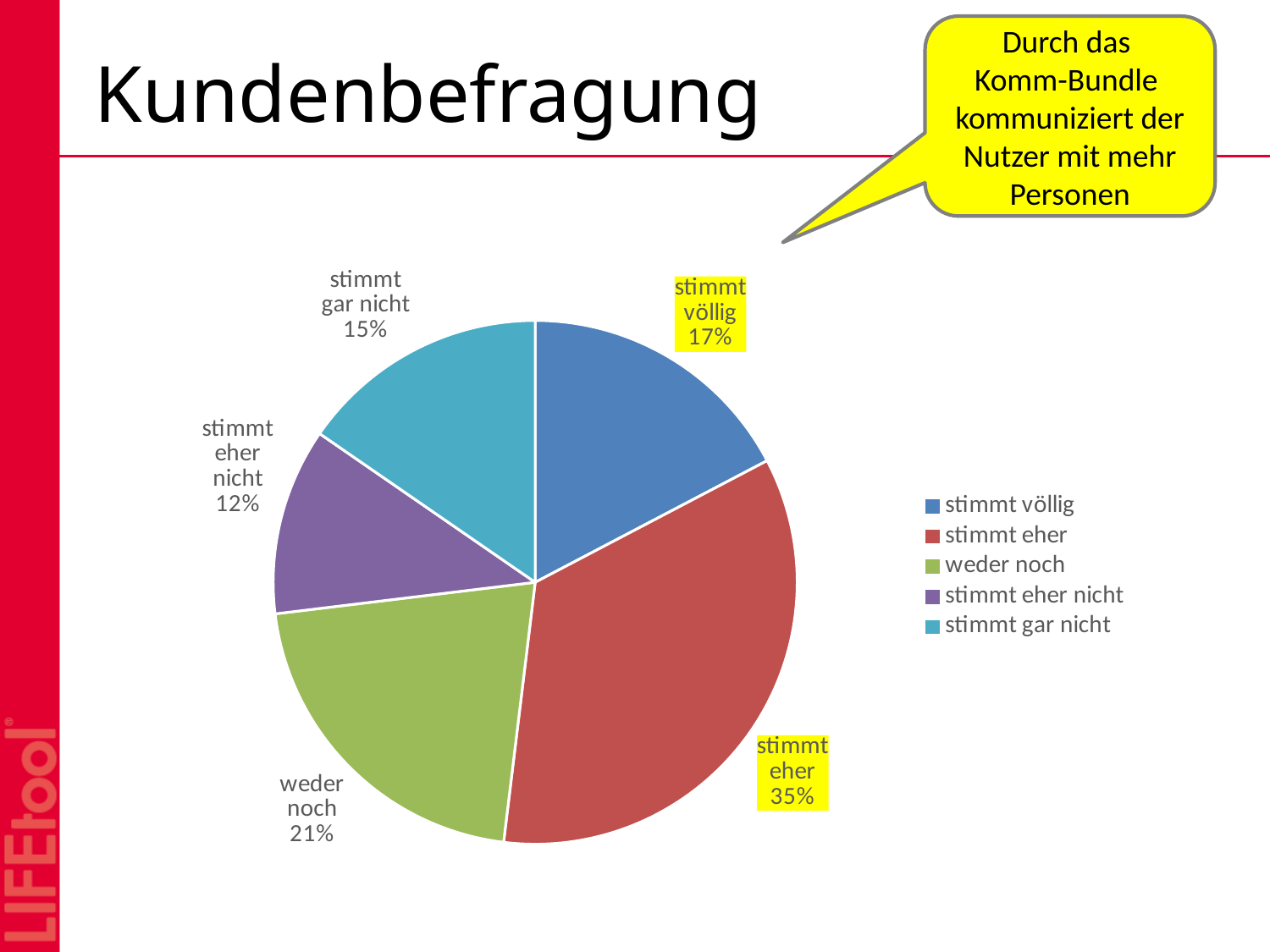
What kind of chart is shown on the slide? pie chart What is the value shown for "stimmt gar nicht"? 15% What is the value shown for "weder noch"? 21% Which category has the largest slice of the pie? stimmt eher What is the value shown for "stimmt eher nicht"? 12% Which category has the smallest slice of the pie? stimmt eher nicht What share of the pie does "stimmt völlig" have? 17% What is the difference in percentage points between "stimmt eher" and "stimmt völlig"? 18 What share of the pie does "stimmt eher" have? 35% How many categories does the pie chart show? 5 Which is larger, "weder noch" or "stimmt gar nicht"? weder noch What colour is the "stimmt eher" slice? red